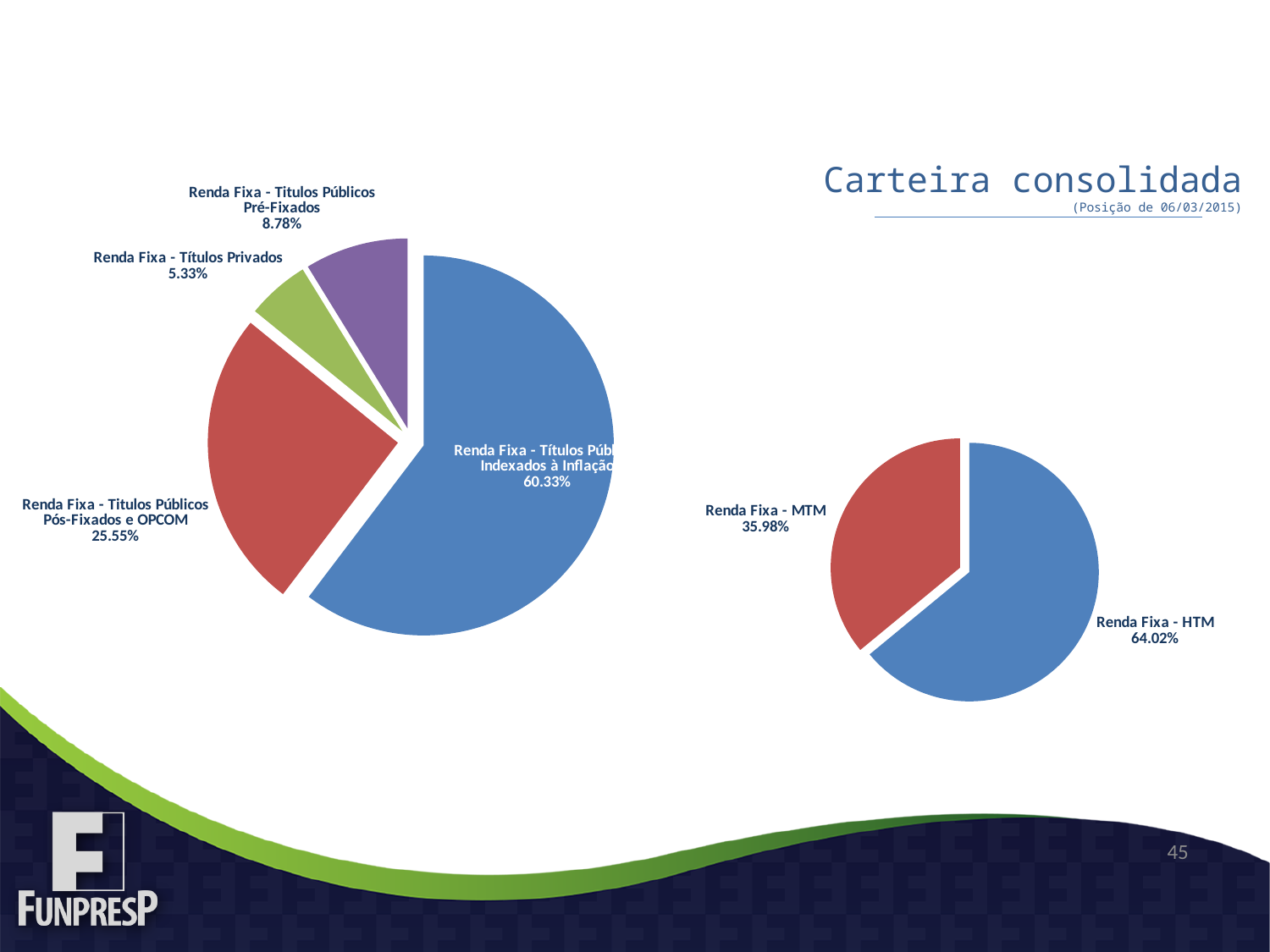
In the right pie chart, what share is labelled for Renda Fixa - MTM? 35.98% In the left pie chart, what is the difference between the shares of Renda Fixa - Titulos Públicos Pré-Fixados and Renda Fixa - Títulos Privados? 3.45% In the left pie chart, how many slices are there? 4 In the left pie chart, what share is labelled for Renda Fixa - Títulos Privados? 5.33% What kind of chart is the chart on the right of the slide? Pie chart In the right pie chart, what share is labelled for Renda Fixa - HTM? 64.02% In the left pie chart, what share is labelled for Renda Fixa - Títulos Públicos Indexados à Inflação? 60.33% In the left pie chart, which slice is the largest? Renda Fixa - Títulos Públicos Indexados à Inflação In the right pie chart, which is larger, Renda Fixa - HTM or Renda Fixa - MTM? Renda Fixa - HTM What is the title shown on the slide above the charts? Carteira consolidada In the left pie chart, what share is labelled for Renda Fixa - Titulos Públicos Pós-Fixados e OPCOM? 25.55% In the left pie chart, which slice is the smallest? Renda Fixa - Títulos Privados